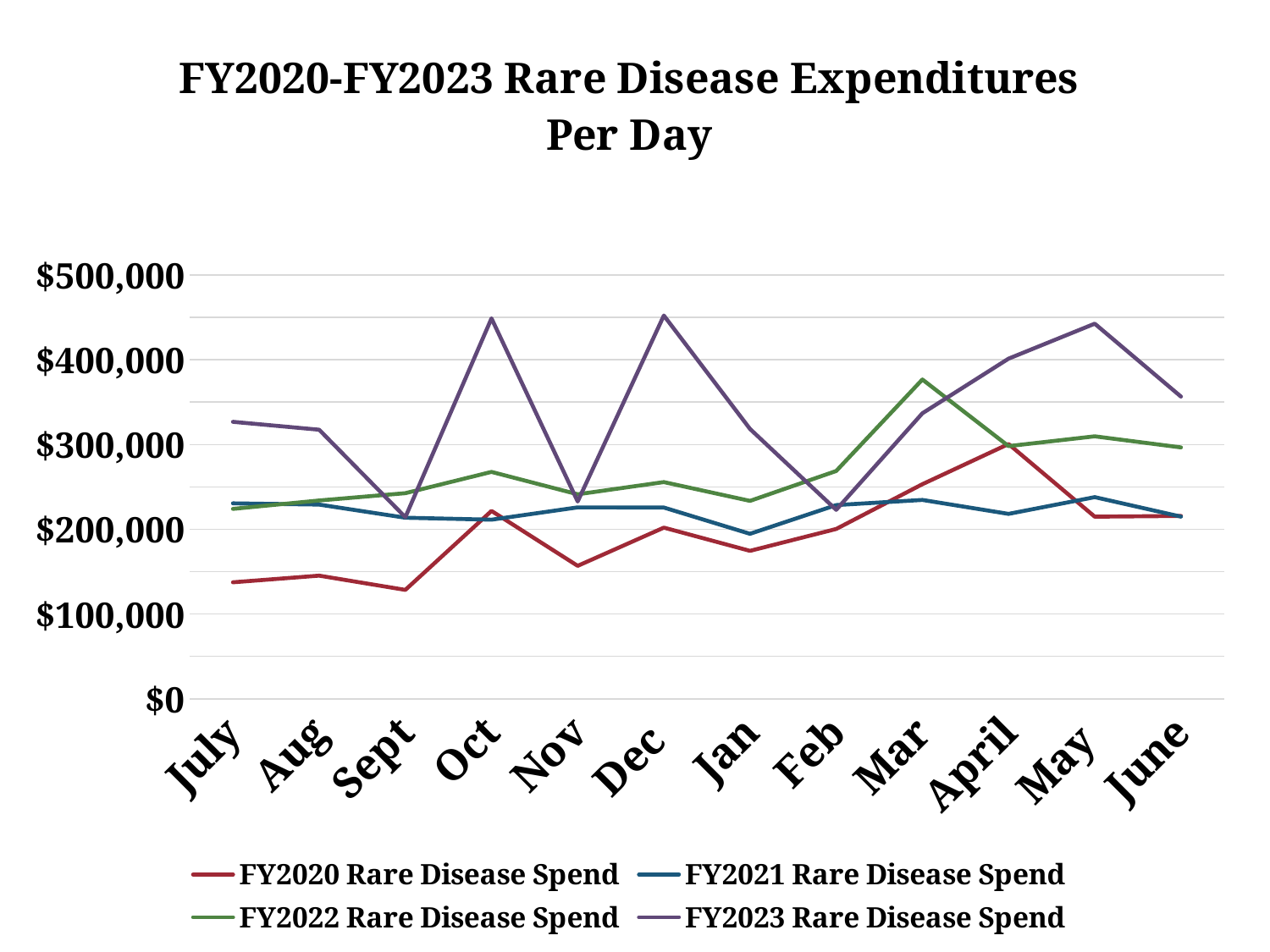
What is the title of the chart? FY2020-FY2023 Rare Disease Expenditures Per Day Is the FY2021 Rare Disease Spend value for July greater or less than $300,000? less Is the FY2020 Rare Disease Spend value for Sept greater or less than $200,000? less How many series does the legend list? 4 Is the FY2022 Rare Disease Spend value for Mar greater or less than $300,000? greater In which month is the FY2020 Rare Disease Spend highest? April What type of chart is shown on the slide? line chart In which month is the FY2022 Rare Disease Spend highest? Mar How many months are shown along the x axis? 12 Does the FY2023 Rare Disease Spend rise or fall from Sept to Oct? rise In Oct, which is larger: FY2023 Rare Disease Spend or FY2021 Rare Disease Spend? FY2023 Rare Disease Spend